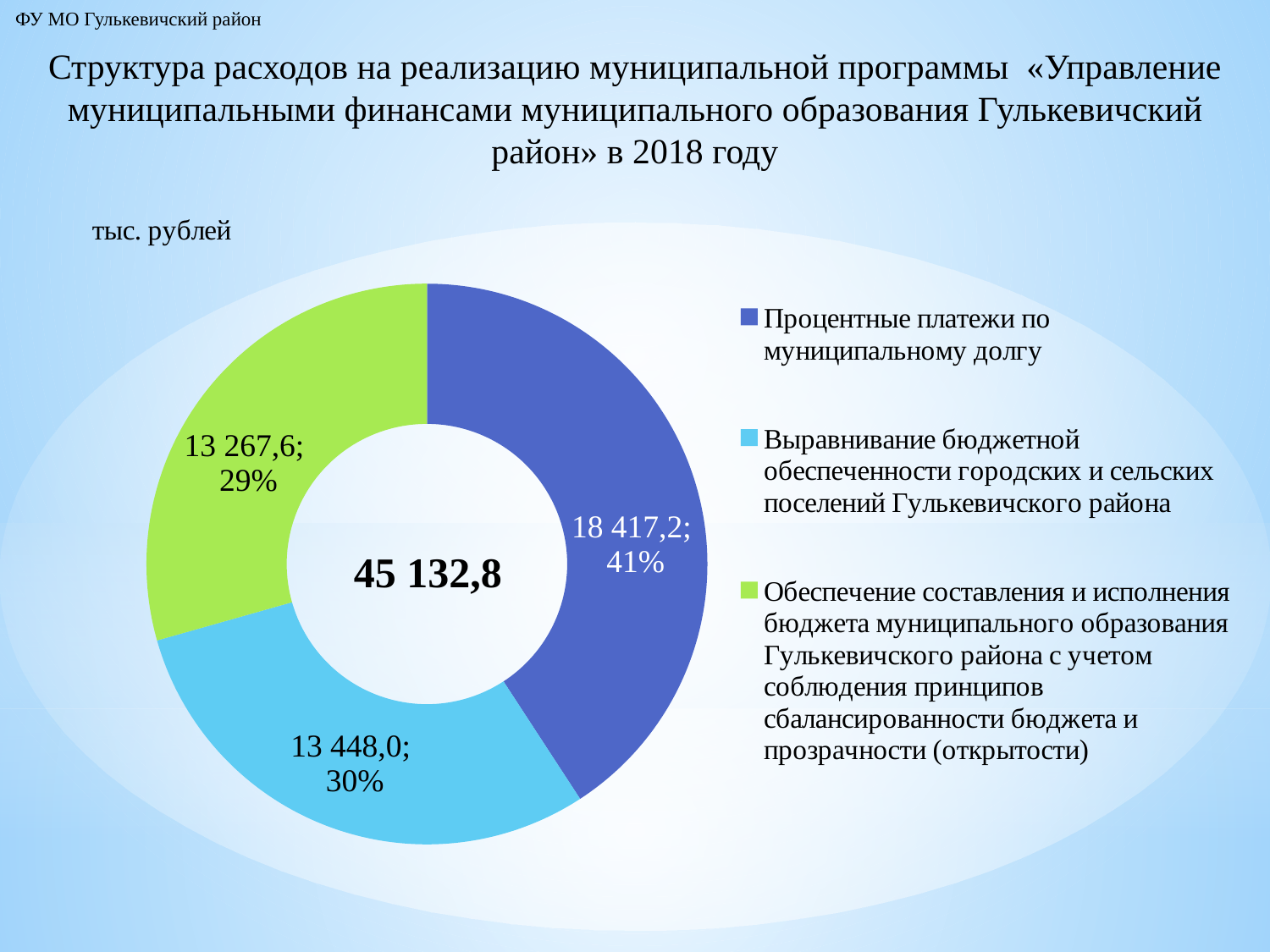
What is the value for «Обеспечение составления и исполнения бюджета муниципального образования Гулькевичского района...»? 13 267,6 What is the difference between «Процентные платежи по муниципальному долгу» and «Выравнивание бюджетной обеспеченности...»? 4 969,2 Which is larger: «Выравнивание бюджетной обеспеченности...» or «Обеспечение составления и исполнения бюджета...»? Выравнивание бюджетной обеспеченности городских и сельских поселений Гулькевичского района How many categories does the chart show? 3 What is the value for «Процентные платежи по муниципальному долгу»? 18 417,2 What share of the total does «Процентные платежи по муниципальному долгу» represent? 41% What share of the total does «Обеспечение составления и исполнения бюджета...» represent? 29% What total value is shown in the centre of the chart? 45 132,8 Which category has the smallest value? Обеспечение составления и исполнения бюджета муниципального образования Гулькевичского района What is the value for «Выравнивание бюджетной обеспеченности городских и сельских поселений Гулькевичского района»? 13 448,0 Which category has the largest value? Процентные платежи по муниципальному долгу What kind of chart is shown on the slide? Doughnut (pie) chart